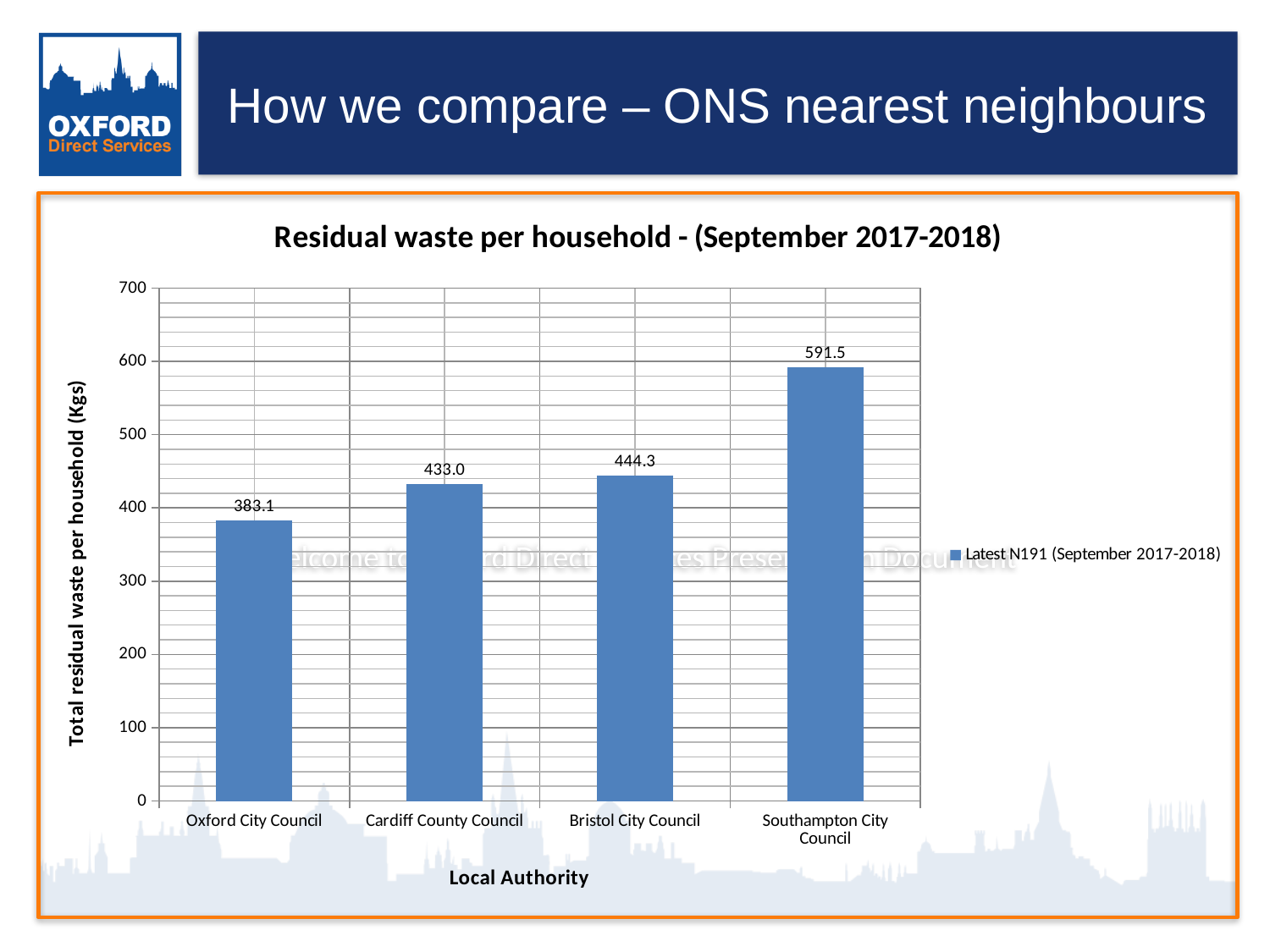
What is the residual waste per household for Southampton City Council? 591.5 How many local authorities are shown in the chart? 4 Which local authority has the highest residual waste per household? Southampton City Council What is the difference between the values for Bristol City Council and Cardiff County Council? 11.3 What is the title of the chart? Residual waste per household - (September 2017-2018) What is the difference between the values for Southampton City Council and Oxford City Council? 208.4 Is the value for Southampton City Council greater or less than 500? greater What is the value shown for Cardiff County Council? 433.0 Which has a higher value, Bristol City Council or Oxford City Council? Bristol City Council Which local authority has the lowest residual waste per household? Oxford City Council What is the residual waste per household for Oxford City Council? 383.1 What kind of chart is shown on the slide? Bar chart